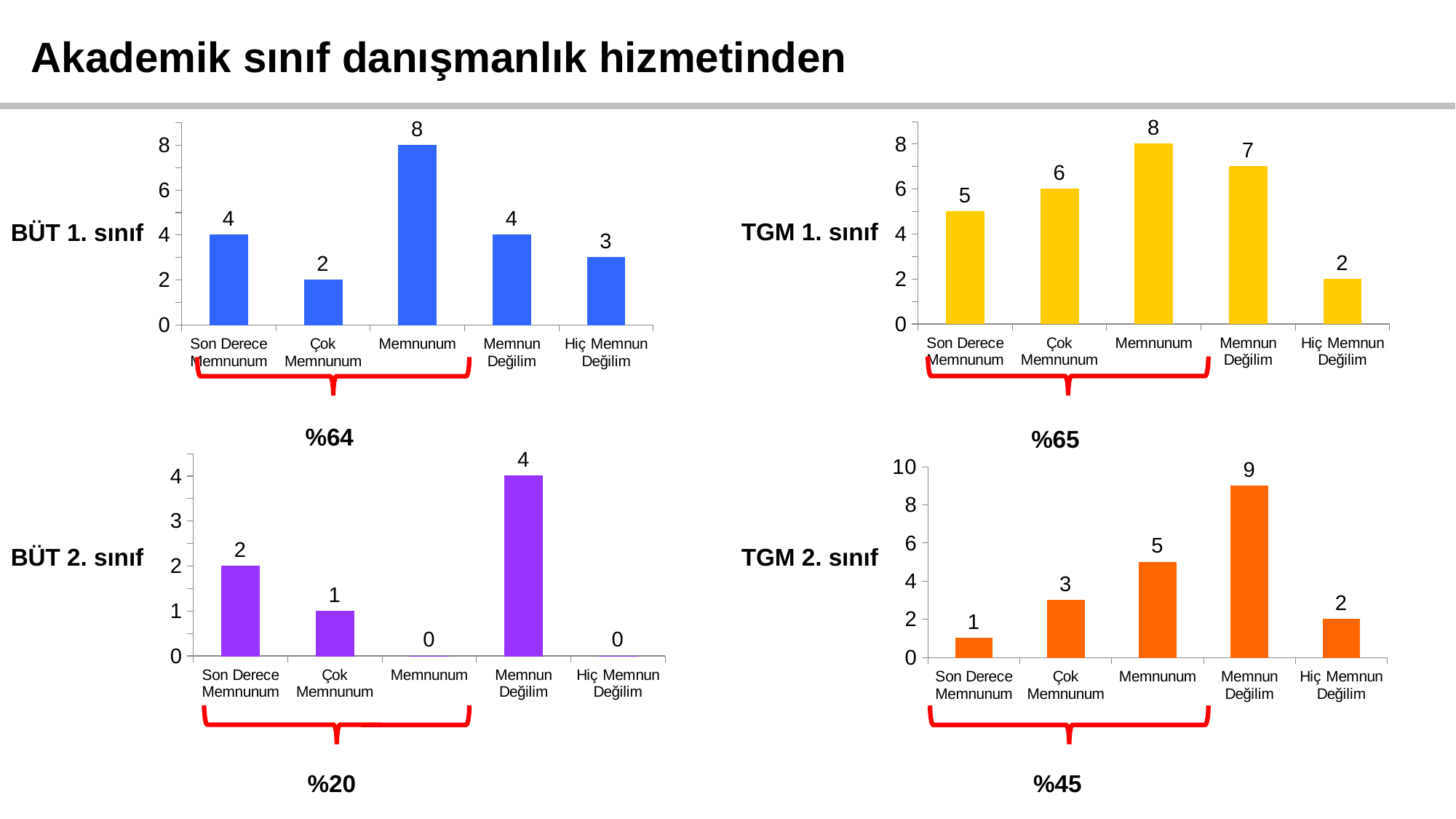
What colour are the bars in the TGM 1. sınıf chart? Yellow What percentage is shown under the bracket for the BÜT 2. sınıf chart? %20 In the TGM 1. sınıf chart, what is the difference between Memnunum and Hiç Memnun Değilim? 6 In the BÜT 2. sınıf chart, what is the value for Memnunum? 0 In the TGM 2. sınıf chart, what is the total of Son Derece Memnunum, Çok Memnunum and Memnunum? 9 In the TGM 1. sınıf chart, what is the value for Memnun Değilim? 7 In the BÜT 1. sınıf chart, what is the value for Memnunum? 8 In the TGM 2. sınıf chart, which is larger: Çok Memnunum or Memnunum? Memnunum What type of chart is the TGM 1. sınıf chart? Bar chart In the TGM 2. sınıf chart, which category has the highest value? Memnun Değilim How many categories are shown in the BÜT 2. sınıf chart? 5 In the BÜT 1. sınıf chart, which category has the lowest value? Çok Memnunum